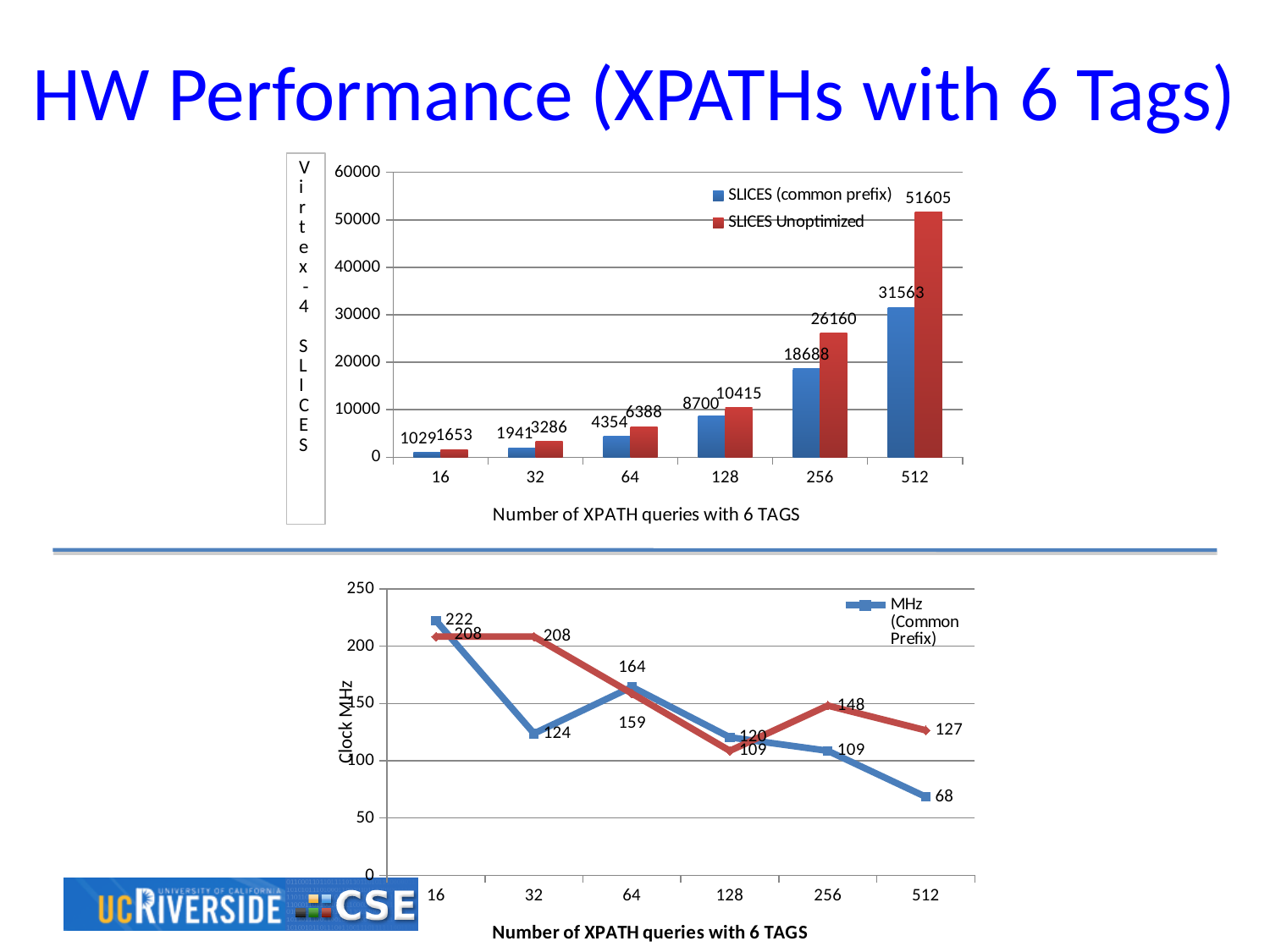
What is the x-axis title of the bottom line chart? Number of XPATH queries with 6 TAGS In the top bar chart, do the SLICES (common prefix) values rise or fall as the number of XPATH queries increases? rise In the bottom line chart, what is the MHz (Common Prefix) value at 512 XPATH queries? 68 In the top bar chart, how many categories are shown on the x axis? 6 What kind of chart is the top chart on the slide? bar chart In the top bar chart, what is the SLICES (common prefix) value at 256 XPATH queries? 18688 In the top bar chart, how many series does the legend list? 2 In the top bar chart, which series has the larger value at 64 XPATH queries? SLICES Unoptimized In the bottom line chart, at which number of XPATH queries is the MHz (Common Prefix) value lowest? 512 In the top bar chart, what is the difference between SLICES Unoptimized and SLICES (common prefix) at 128 XPATH queries? 1715 In the top bar chart, what is the SLICES Unoptimized value at 512 XPATH queries? 51605 In the bottom line chart, what is the difference between the MHz (Common Prefix) values at 16 and 32 XPATH queries? 98